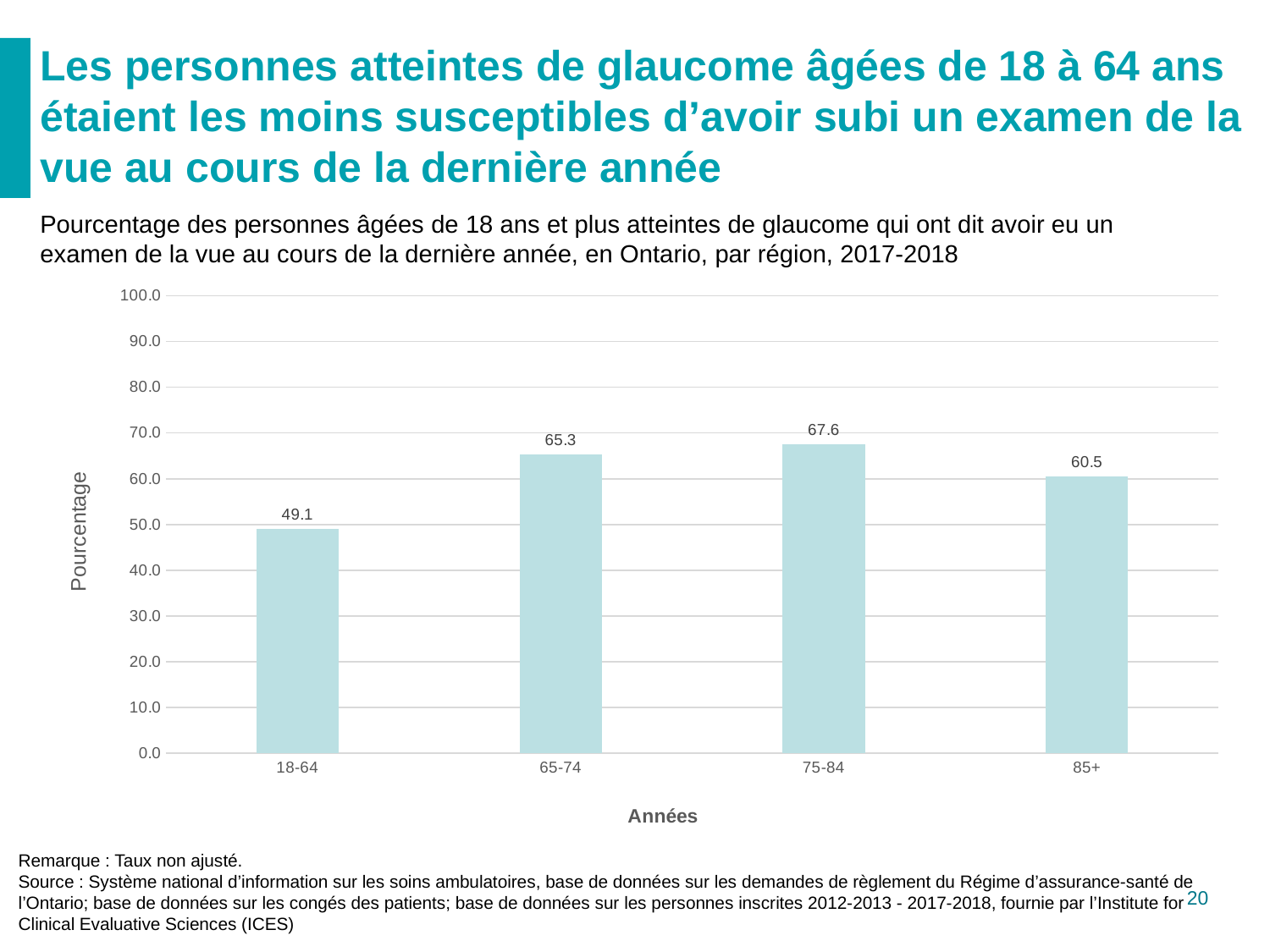
What is the label of the y axis? Pourcentage Which age group has the highest value? 75-84 What is the value for the 85+ age group? 60.5 Is the value for 18-64 greater or less than 50.0? less What kind of chart is shown on the slide? bar chart Which age group has the lowest value? 18-64 Which is larger, the value for 65-74 or the value for 85+? 65-74 What is the value for the 18-64 age group? 49.1 What is the value for the 65-74 age group? 65.3 What is the difference between the values for 75-84 and 18-64? 18.5 How many age groups are shown on the x axis? 4 What is the difference between the values for 65-74 and 85+? 4.8